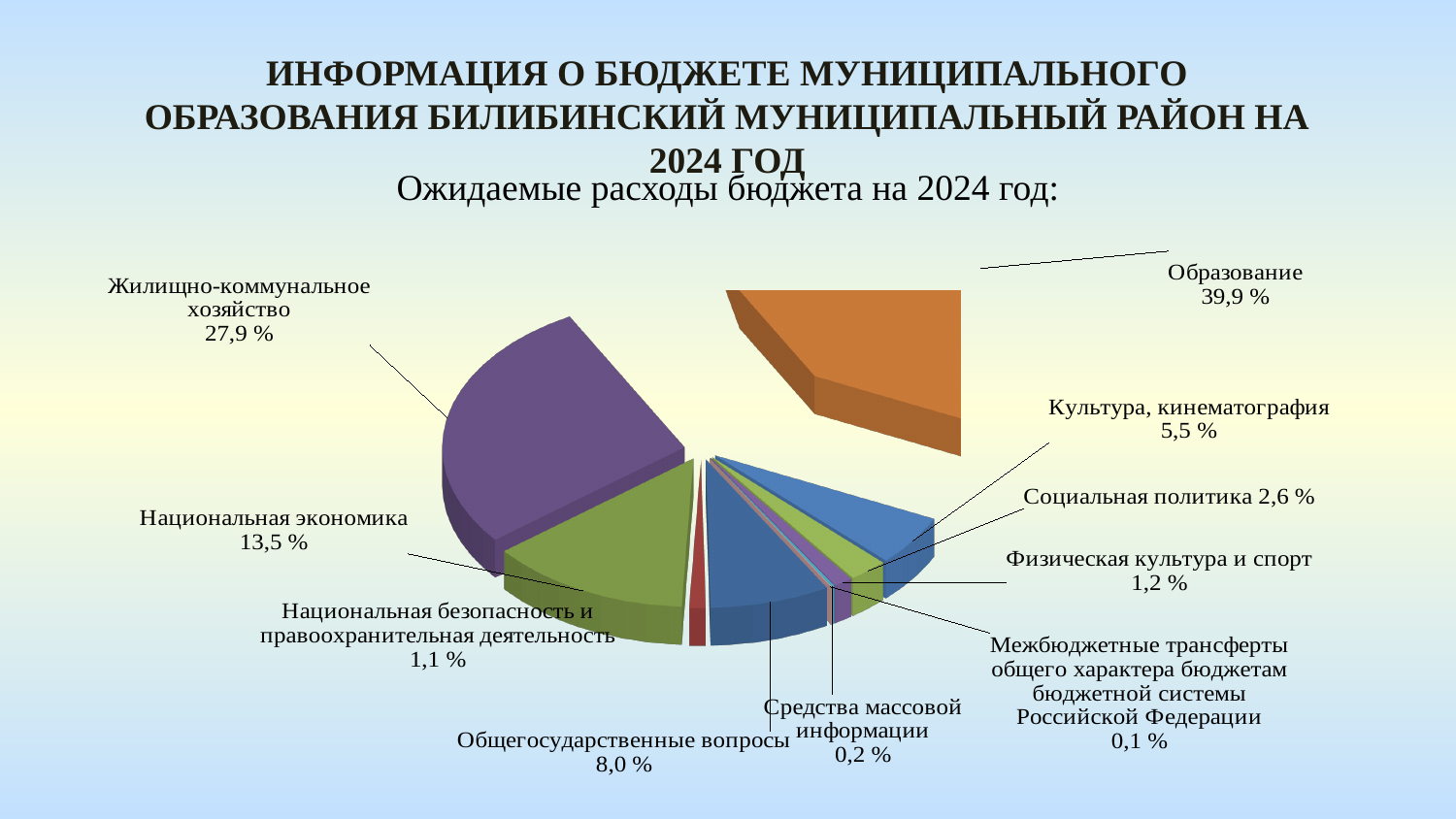
What is the value shown for Жилищно-коммунальное хозяйство? 27,9 % What share is shown for Социальная политика? 2,6 % How many categories are shown in the pie chart? 10 What percentage is shown for Национальная экономика? 13,5 % What is the subtitle above the pie chart? Ожидаемые расходы бюджета на 2024 год: Which is larger: the share for Культура, кинематография or the share for Общегосударственные вопросы? Общегосударственные вопросы Which category has the largest share of the pie? Образование Which category has the smallest share of the pie? Межбюджетные трансферты общего характера бюджетам бюджетной системы Российской Федерации What share of expected 2024 budget expenditures goes to Образование? 39,9 % What kind of chart is shown on the slide? pie chart What is the value for Общегосударственные вопросы? 8,0 % What is the difference between the shares of Образование and Жилищно-коммунальное хозяйство? 12,0 %